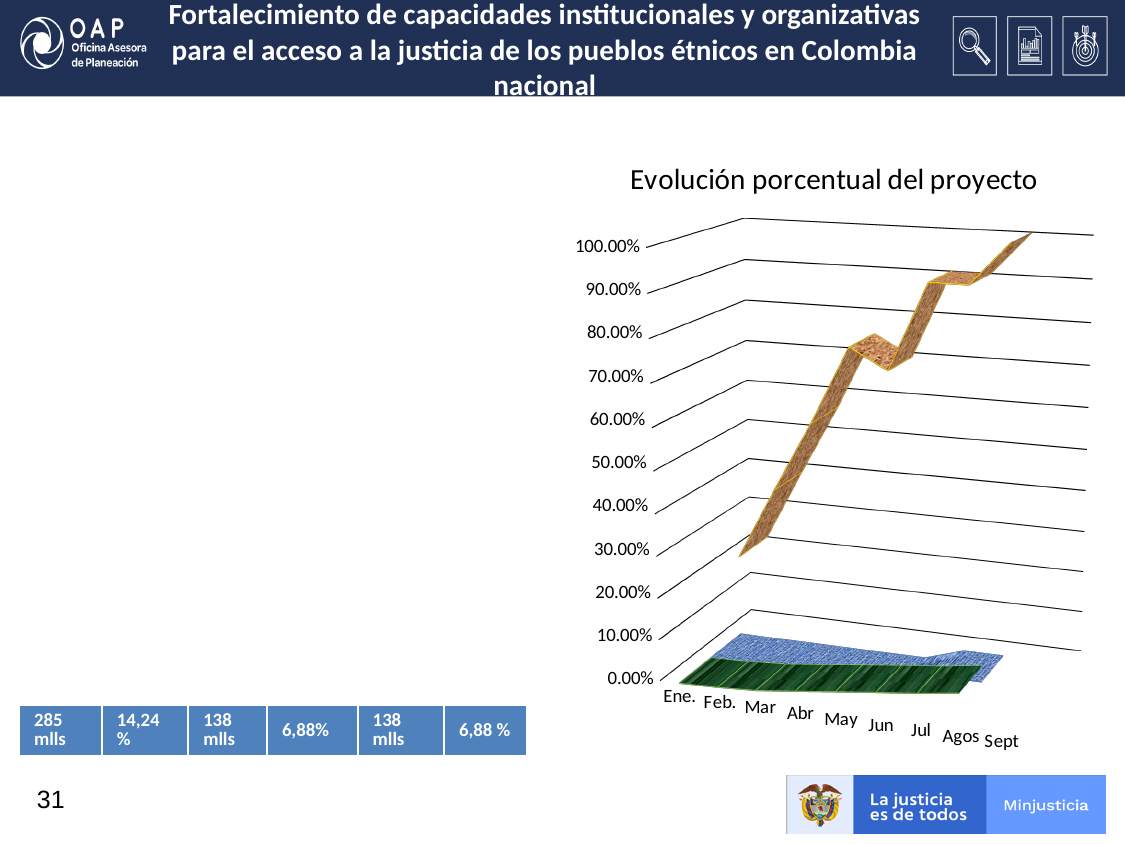
What is the last category on the x axis of the chart? Sept Does the upper (orange) series rise or fall from Ene. to Sept? rise How many months are shown along the x axis of the chart? 9 Is the value of the lower (blue) series in Mar greater or less than 30.00%? less What is the first category on the x axis of the chart? Ene. What is the highest value shown on the vertical axis of the chart? 100.00% What is the title of the chart on the slide? Evolución porcentual del proyecto Is the value of the upper (orange) series in Ene. greater or less than 60.00%? less Which series is higher in Jul, the upper (orange) series or the lower (blue) series? the upper (orange) series In which month is the upper (orange) series at its lowest value? Ene. In which month does the upper (orange) series reach its highest value? Agos